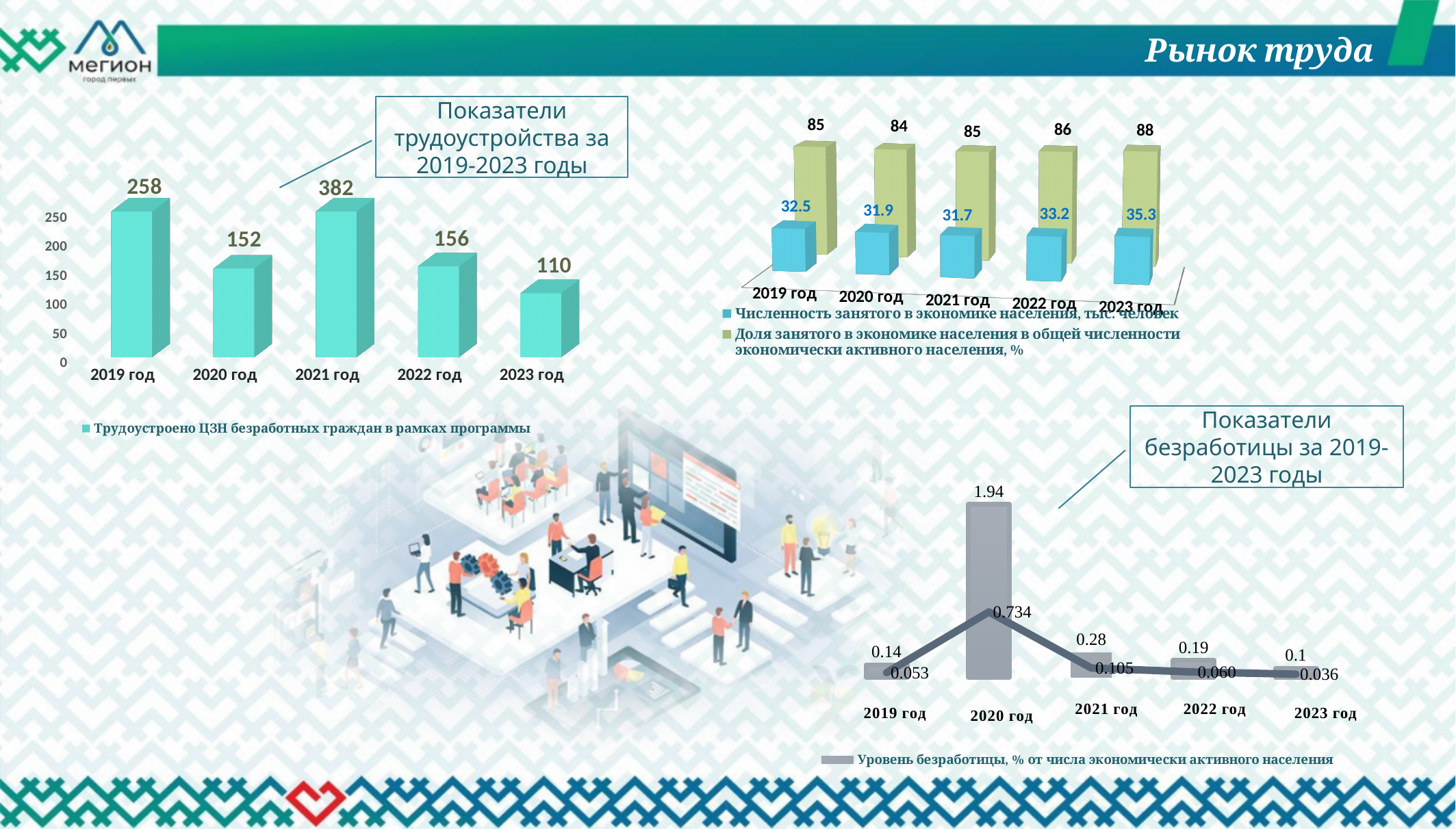
In the chart titled 'Показатели безработицы за 2019-2023 годы', which year has the highest bar value? 2020 год In the chart titled 'Показатели трудоустройства за 2019-2023 годы', which year has the lowest value? 2023 год In the top-right chart, how many series does the legend list? 2 In the chart titled 'Показатели трудоустройства за 2019-2023 годы', which year has the highest value? 2021 год In the chart titled 'Показатели безработицы за 2019-2023 годы', what is the bar value for 2020 год? 1.94 What kind of chart is the chart titled 'Показатели трудоустройства за 2019-2023 годы'? bar chart In the top-right chart, what is the value of 'Доля занятого в экономике населения в общей численности экономически активного населения, %' for 2020 год? 84 In the chart titled 'Показатели трудоустройства за 2019-2023 годы', how many years are shown on the x axis? 5 In the chart titled 'Показатели трудоустройства за 2019-2023 годы', what is the value for 2021 год? 382 In the top-right chart, which year has the lowest value of 'Численность занятого в экономике населения, тыс. человек'? 2021 год In the chart titled 'Показатели трудоустройства за 2019-2023 годы', what is the difference between the values for 2019 год and 2020 год? 106 In the top-right chart, what is the value of 'Численность занятого в экономике населения, тыс. человек' for 2023 год? 35.3